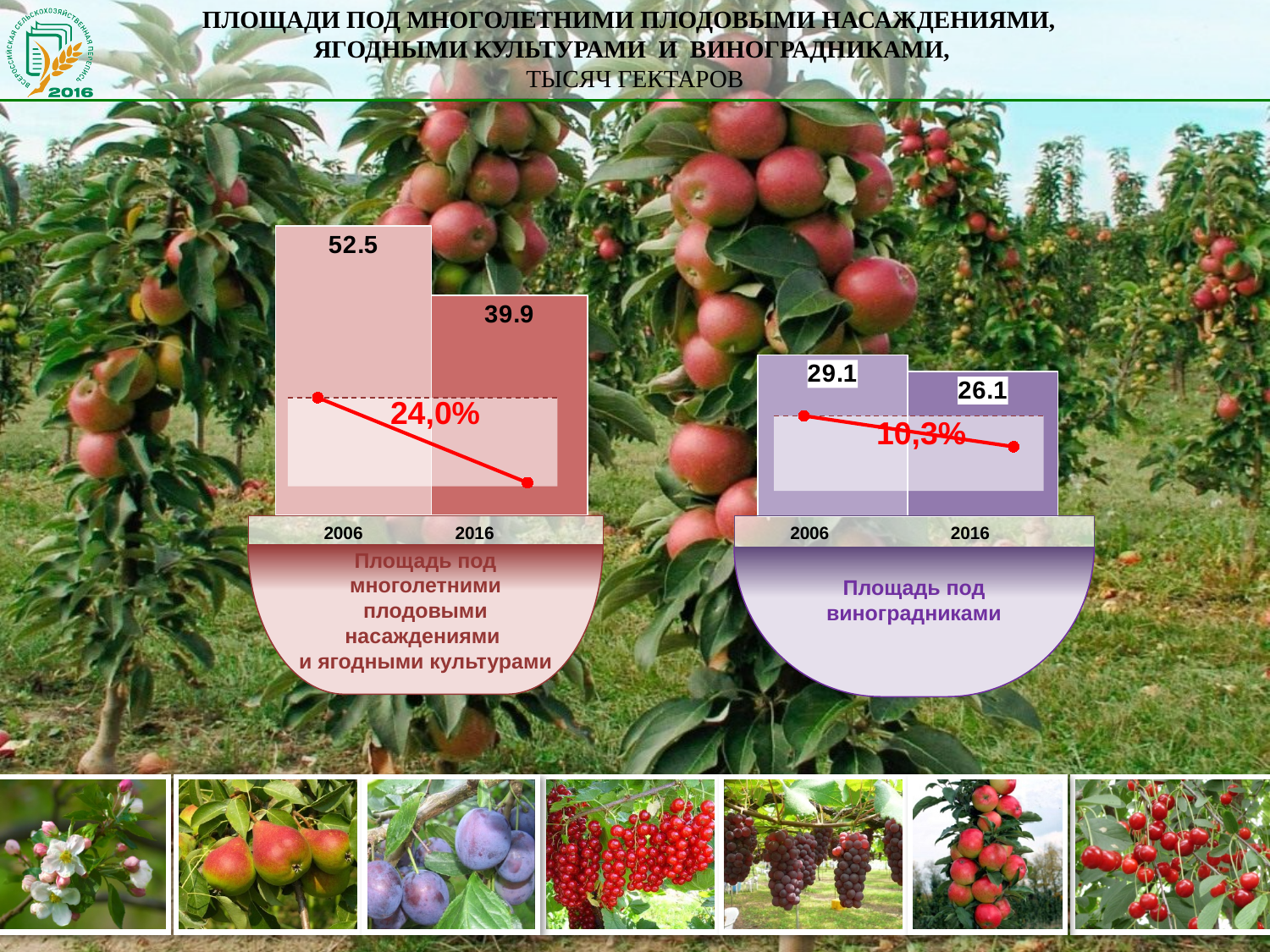
On the right chart (Площадь под виноградниками), what is the value for 2016? 26.1 On the right chart (Площадь под виноградниками), do the values rise or fall from 2006 to 2016? fall How many years (categories) are shown on the right chart (Площадь под виноградниками)? 2 On the left chart (Площадь под многолетними плодовыми насаждениями и ягодными культурами), which year has the higher value? 2006 On the left chart (Площадь под многолетними плодовыми насаждениями и ягодными культурами), what is the value for 2016? 39.9 On the left chart (Площадь под многолетними плодовыми насаждениями и ягодными культурами), by how much did the value decrease from 2006 to 2016? 12.6 On the right chart (Площадь под виноградниками), what is the value for 2006? 29.1 On the left chart (Площадь под многолетними плодовыми насаждениями и ягодными культурами), what is the value for 2006? 52.5 What kind of chart is used on the left to show the area under perennial fruit plantations and berry crops? bar chart On the left chart (Площадь под многолетними плодовыми насаждениями и ягодными культурами), what percentage change is shown between 2006 and 2016? 24,0% On the right chart (Площадь под виноградниками), by how much did the value decrease from 2006 to 2016? 3.0 On the right chart (Площадь под виноградниками), what percentage change is shown between 2006 and 2016? 10,3%